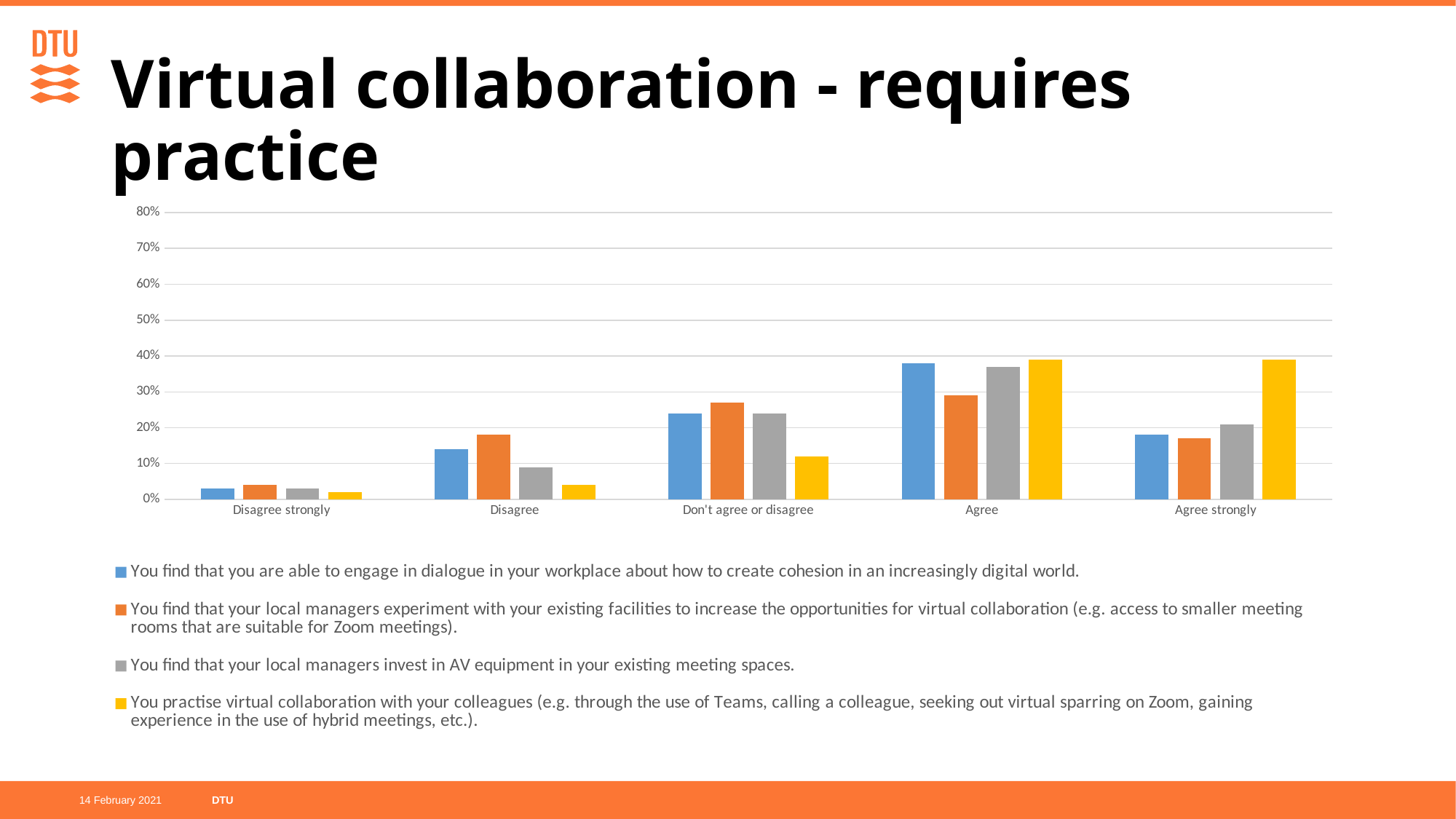
Is the value for 'You find that your local managers experiment with your existing facilities' at 'Disagree' greater or less than 10%? greater What kind of chart is shown on the slide? bar chart For the series 'You find that your local managers invest in AV equipment in your existing meeting spaces', which response category has the highest value? Agree At 'Agree strongly', which is larger: the value for 'You practise virtual collaboration with your colleagues' or the value for 'You find that you are able to engage in dialogue in your workplace'? You practise virtual collaboration with your colleagues Is the value for 'You practise virtual collaboration with your colleagues' at 'Agree strongly' greater or less than 30%? greater At 'Don't agree or disagree', which series has the lowest value? You practise virtual collaboration with your colleagues Is the value for 'You find that you are able to engage in dialogue in your workplace' at 'Agree' greater or less than 30%? greater How many series does the legend list? 4 For the series 'You practise virtual collaboration with your colleagues', which response category has the lowest value? Disagree strongly Which colour represents the series 'You practise virtual collaboration with your colleagues' in the legend? yellow How many response categories are shown along the x axis? 5